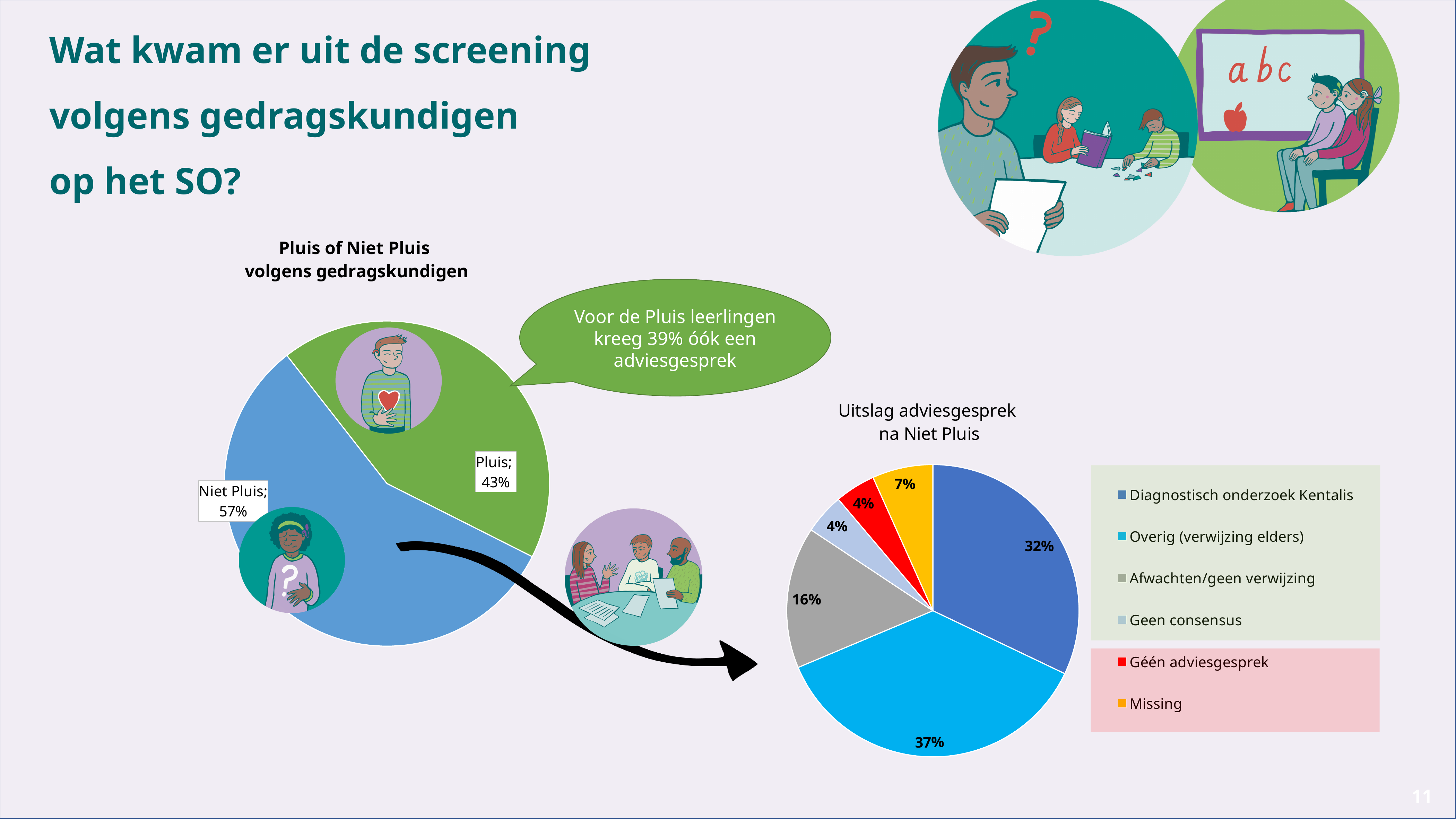
In the 'Pluis of Niet Pluis volgens gedragskundigen' chart, what percentage is Pluis? 43% In the 'Pluis of Niet Pluis volgens gedragskundigen' chart, which slice is larger, Pluis or Niet Pluis? Niet Pluis In the 'Pluis of Niet Pluis volgens gedragskundigen' chart, what percentage is Niet Pluis? 57% How many categories does the legend of the 'Uitslag adviesgesprek na Niet Pluis' chart list? 6 In the 'Uitslag adviesgesprek na Niet Pluis' chart, what is the difference between Overig (verwijzing elders) and Afwachten/geen verwijzing? 21% In the 'Uitslag adviesgesprek na Niet Pluis' chart, what percentage is Missing? 7% In the 'Pluis of Niet Pluis volgens gedragskundigen' chart, what is the difference between the Niet Pluis and Pluis percentages? 14% In the 'Uitslag adviesgesprek na Niet Pluis' chart, which category has the largest share? Overig (verwijzing elders) What kind of chart is 'Uitslag adviesgesprek na Niet Pluis'? Pie chart In the 'Uitslag adviesgesprek na Niet Pluis' chart, what percentage is Overig (verwijzing elders)? 37% In the 'Uitslag adviesgesprek na Niet Pluis' chart, what percentage is Diagnostisch onderzoek Kentalis? 32% In the 'Uitslag adviesgesprek na Niet Pluis' chart, what percentage is Afwachten/geen verwijzing? 16%